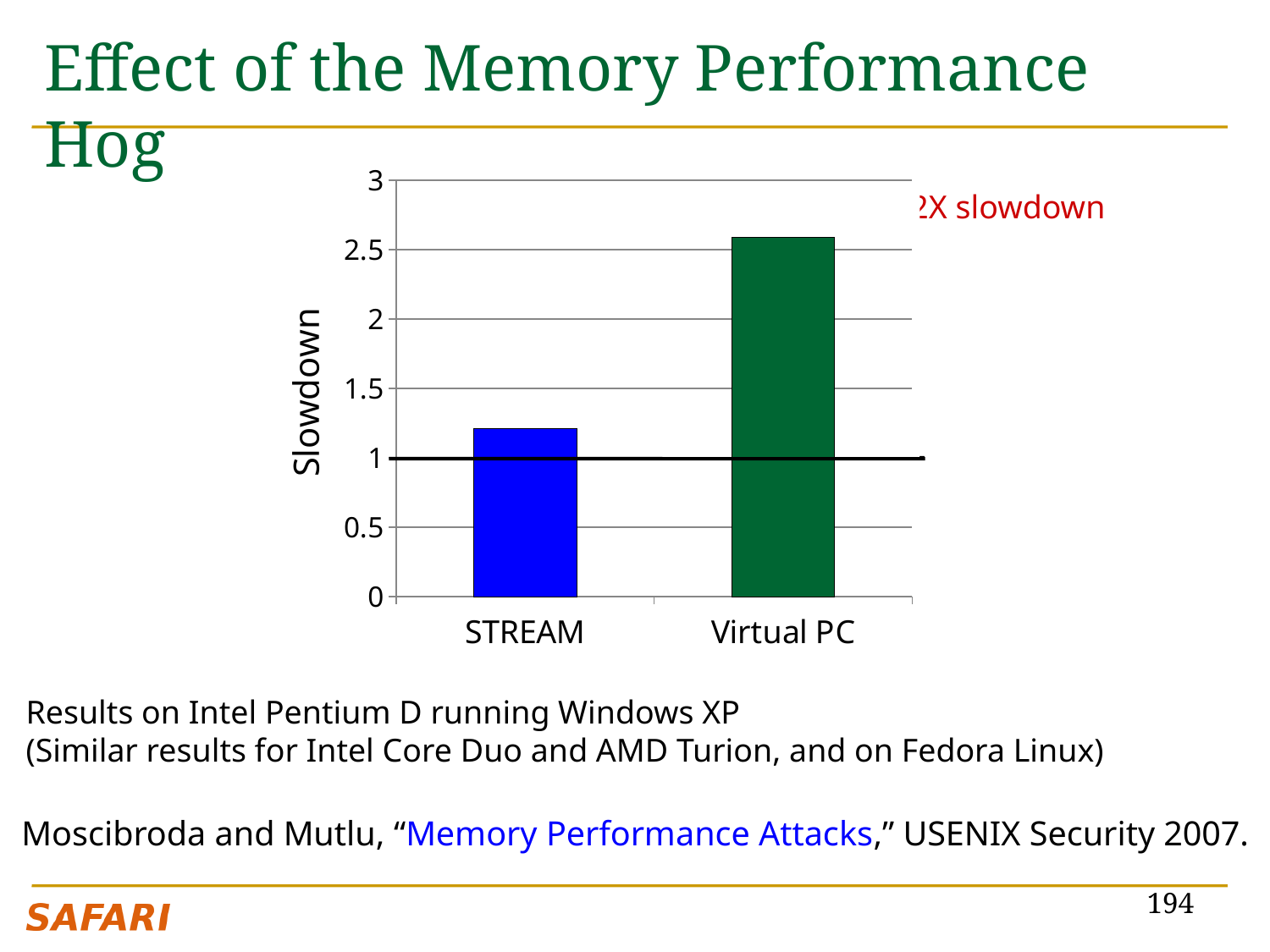
What kind of chart is shown on the slide? bar chart Which category has the lowest slowdown in the chart? STREAM Is the slowdown for Virtual PC greater or less than 2? greater Do the values rise or fall moving from STREAM to Virtual PC along the x axis? rise Is the slowdown for STREAM greater or less than 1? greater Which category has the highest slowdown in the chart? Virtual PC Is the slowdown for STREAM greater or less than 1.5? less How many categories are plotted on the x axis of the chart? 2 What is the label of the y axis of the chart? Slowdown Which has a larger slowdown, STREAM or Virtual PC? Virtual PC What colour is the bar for STREAM? blue